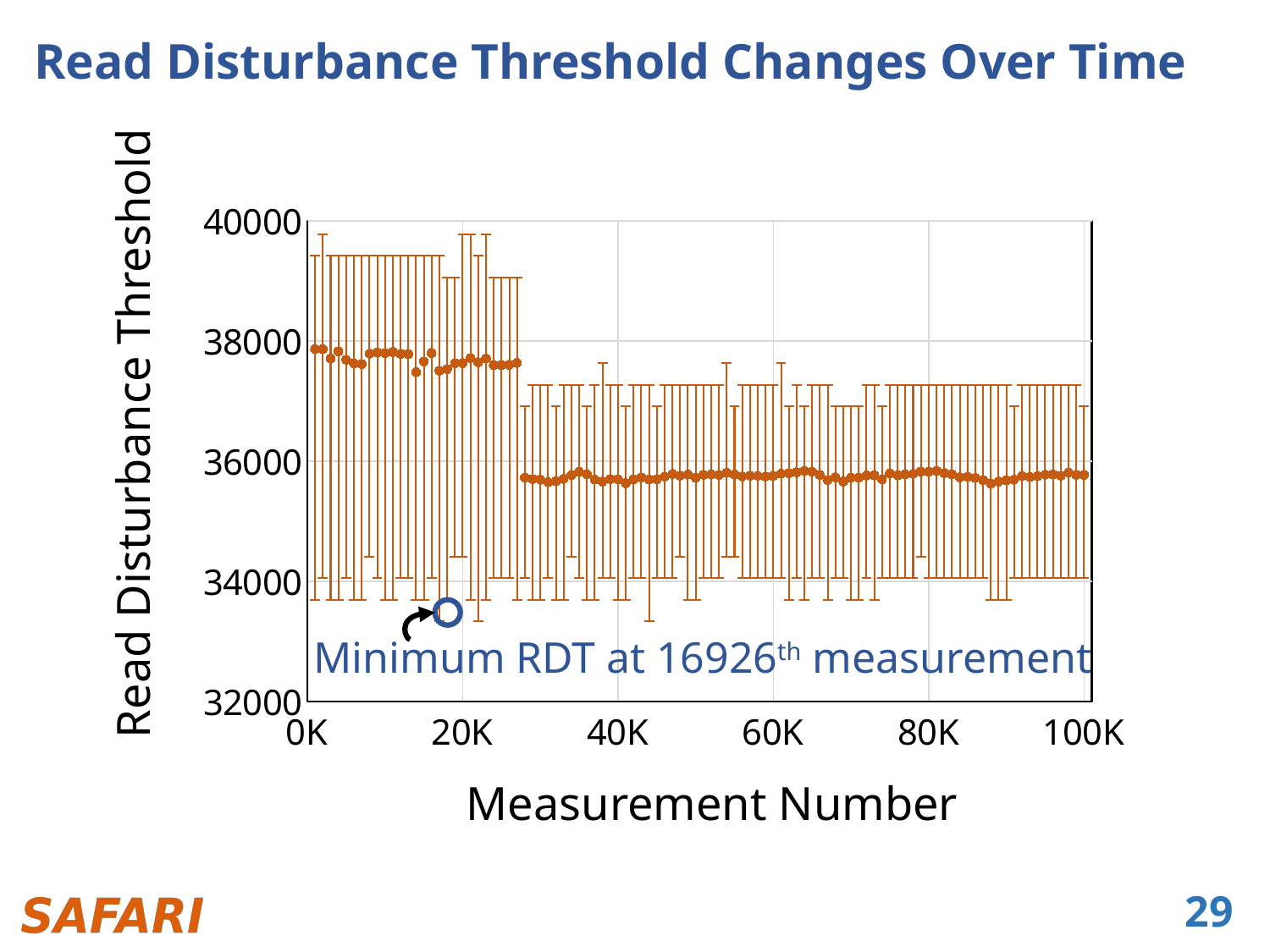
Is the Read Disturbance Threshold at measurement 90K greater or less than 34000? greater At which measurement number does the minimum RDT occur, according to the annotation? 16926th Overall, do the Read Disturbance Threshold values rise or fall from 0K to 100K measurements? fall Is the Read Disturbance Threshold at measurement 20K greater or less than 36000? greater Is the Read Disturbance Threshold at measurement 10K greater or less than 36000? greater Which is larger, the Read Disturbance Threshold at measurement 10K or at measurement 60K? 10K What is the label of the x axis? Measurement Number Which is larger, the Read Disturbance Threshold at measurement 20K or at measurement 80K? 20K What is the title of the chart? Read Disturbance Threshold Changes Over Time What kind of chart is shown? scatter plot with error bars